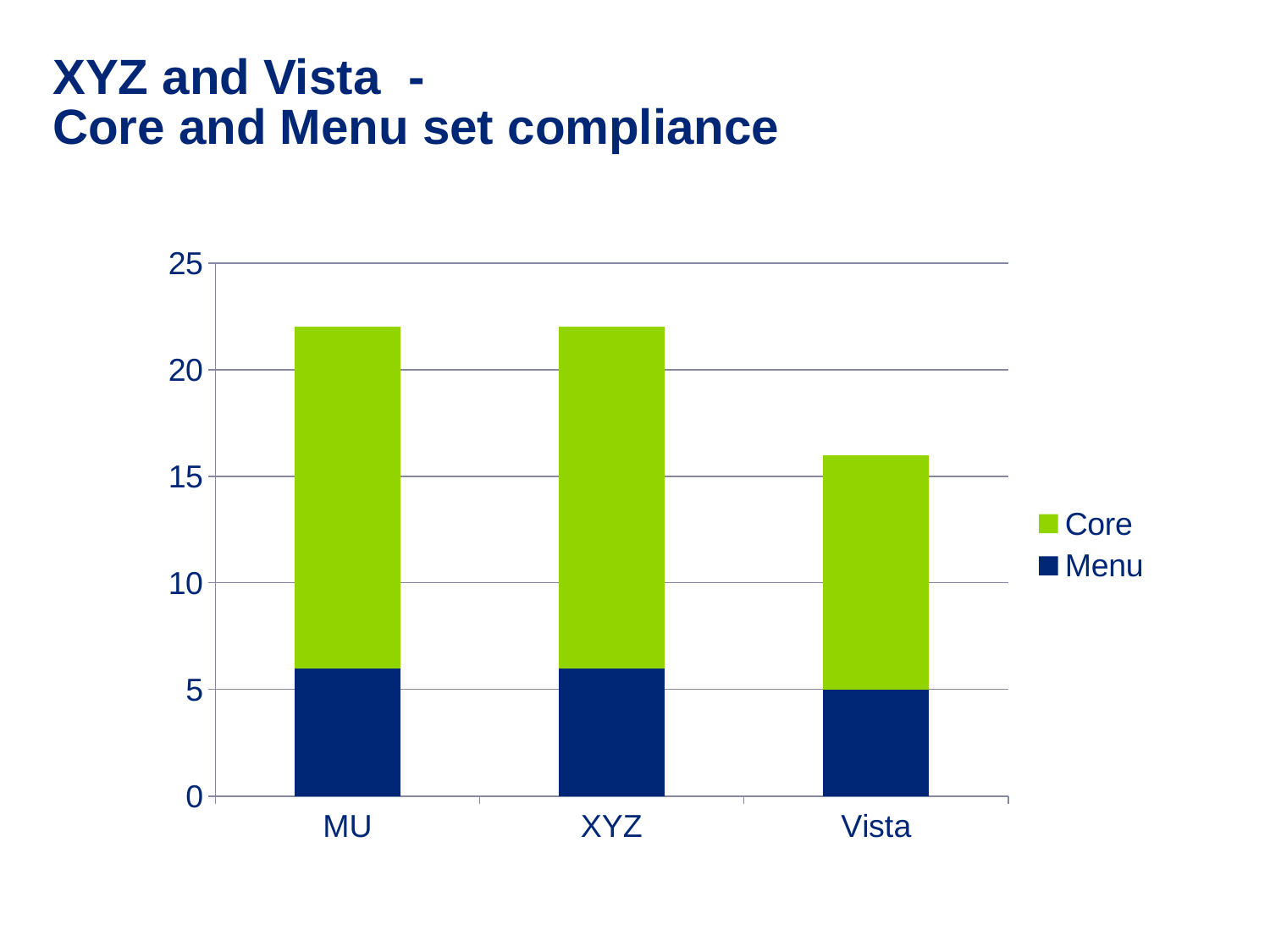
Which has the larger total bar height, XYZ or Vista? XYZ Which colour represents the Core series in the legend? green Is the total bar height for Vista greater or less than 15? greater What is the Menu value for Vista? 5 How many series does the legend list? 2 Is the Menu value for MU greater or less than 5? greater How many categories are shown on the x axis? 3 What is the title of the chart slide? XYZ and Vista - Core and Menu set compliance Which category has the lowest total bar height? Vista Is the total bar height for MU greater or less than 20? greater What kind of chart is shown on the slide? bar chart